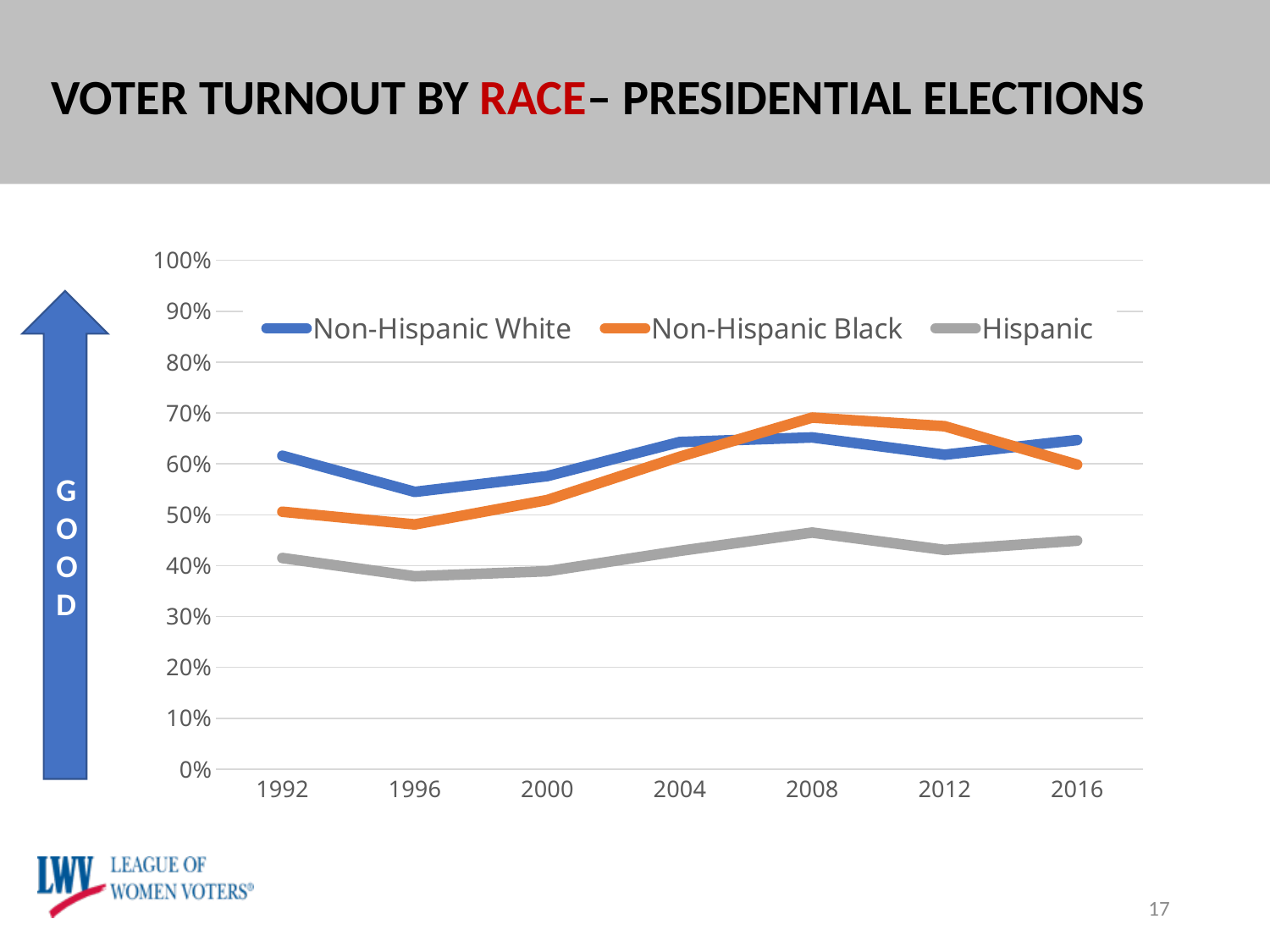
In which year does the Hispanic series reach its highest value? 2008 In 2016, which is higher: Non-Hispanic White or Non-Hispanic Black turnout? Non-Hispanic White Is the Hispanic turnout in 2008 greater or less than 50%? less How many election years are plotted along the x axis? 7 Does the Non-Hispanic Black series rise or fall from 1996 to 2008? Rise Is the Non-Hispanic Black turnout in 1996 greater or less than 50%? less What kind of chart is shown on the slide? Line chart How many series does the chart's legend list? 3 What is the title of the slide containing the chart? VOTER TURNOUT BY RACE – PRESIDENTIAL ELECTIONS Which series has the highest turnout in 2008? Non-Hispanic Black In which year is the Non-Hispanic White series at its lowest? 1996 Is the Non-Hispanic Black turnout in 2008 greater or less than 60%? greater